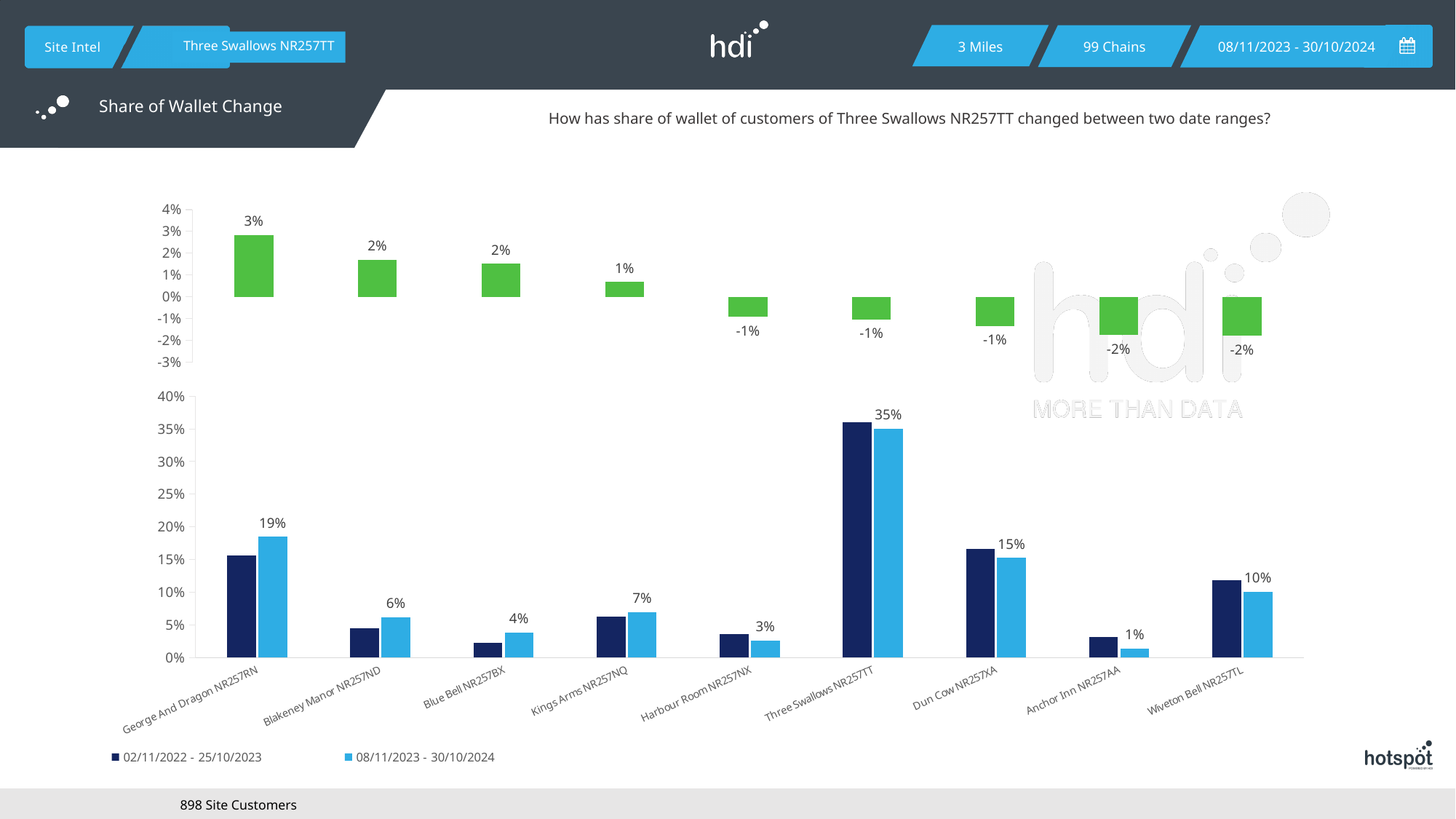
In the bottom chart, is the 02/11/2022 - 25/10/2023 share of wallet for Three Swallows NR257TT greater or less than 30%? greater In the top chart, how many categories have a negative share of wallet change? 5 In the bottom chart, which category has the lowest share of wallet in the 08/11/2023 - 30/10/2024 period? Anchor Inn NR257AA What type of chart is the bottom chart? Bar chart In the bottom chart, which is larger for Kings Arms NR257NQ: the 02/11/2022 - 25/10/2023 bar or the 08/11/2023 - 30/10/2024 bar? 08/11/2023 - 30/10/2024 In the bottom chart, what is the share of wallet for Three Swallows NR257TT in the 08/11/2023 - 30/10/2024 period? 35% In the top chart, what is the share of wallet change for George And Dragon NR257RN? 3% In the top chart, what is the share of wallet change for Anchor Inn NR257AA? -2% In the top chart, which category has the highest share of wallet change? George And Dragon NR257RN In the bottom chart, what is the share of wallet for Dun Cow NR257XA in the 08/11/2023 - 30/10/2024 period? 15% In the bottom chart, what is the difference between the 08/11/2023 - 30/10/2024 share of wallet for George And Dragon NR257RN and Wiveton Bell NR257TL? 9% How many series does the legend of the bottom chart list? 2